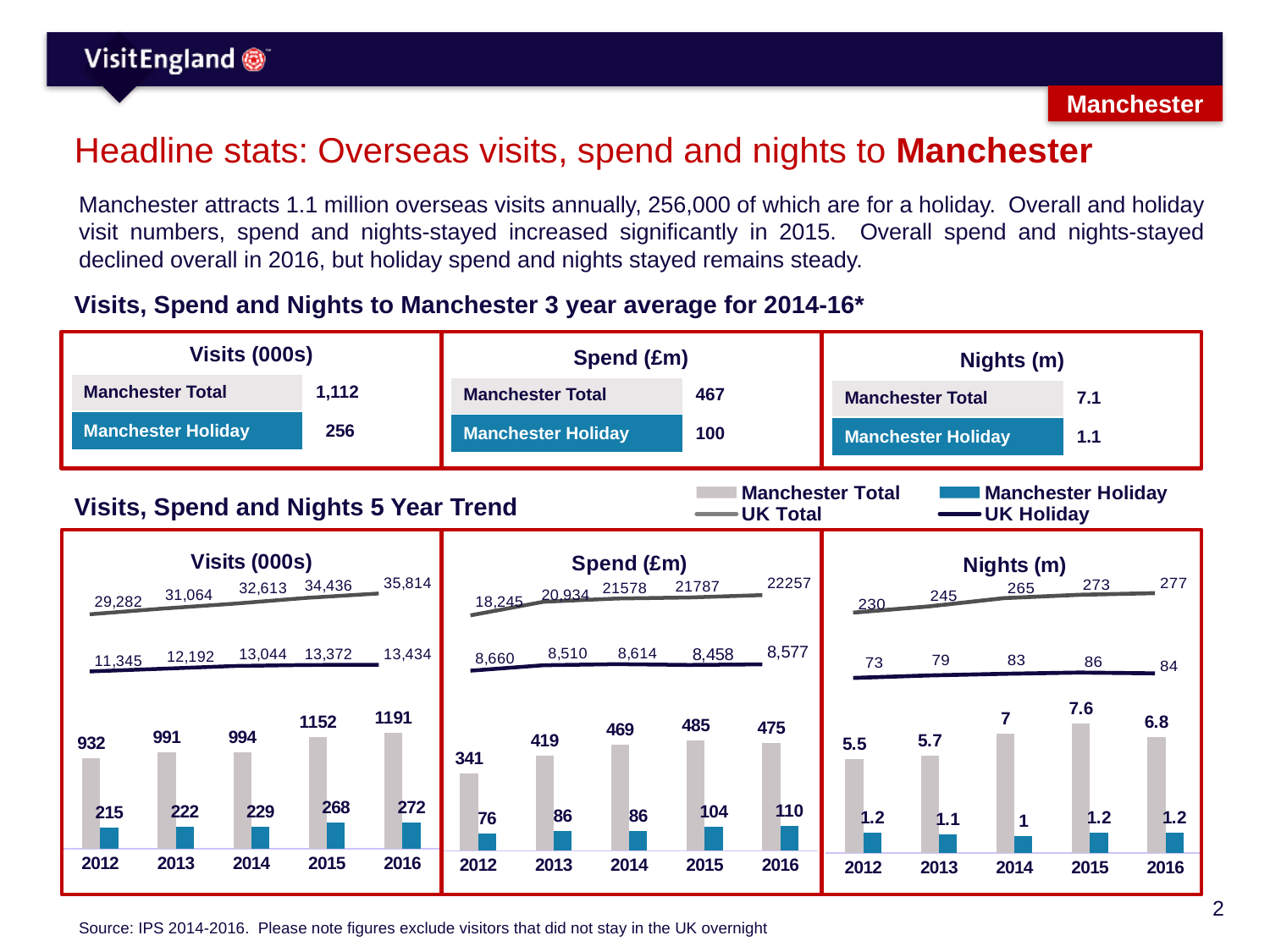
In the Spend (£m) chart, what is the Manchester Holiday value for 2015? 104 In the Visits (000s) chart, which year has the highest Manchester Total value? 2016 In the 5 Year Trend charts, which series is shown in grey bars? Manchester Total In the Visits (000s) chart, what is the Manchester Total value for 2016? 1191 In the Nights (m) chart, what is the UK Total value for 2014? 265 How many series does the legend for the 5 Year Trend charts list? 4 In the Visits (000s) chart, does the UK Total line rise or fall from 2012 to 2016? rise In the Visits (000s) chart, how many years are shown on the x axis? 5 What kind of chart is the Spend (£m) 5 Year Trend chart? Combined bar and line chart In the Nights (m) chart, what is the difference between the Manchester Total values for 2015 and 2016? 0.8 In the Spend (£m) chart, is the Manchester Total value for 2014 larger or smaller than the value for 2015? smaller In the Spend (£m) chart, which year has the lowest Manchester Holiday value? 2012